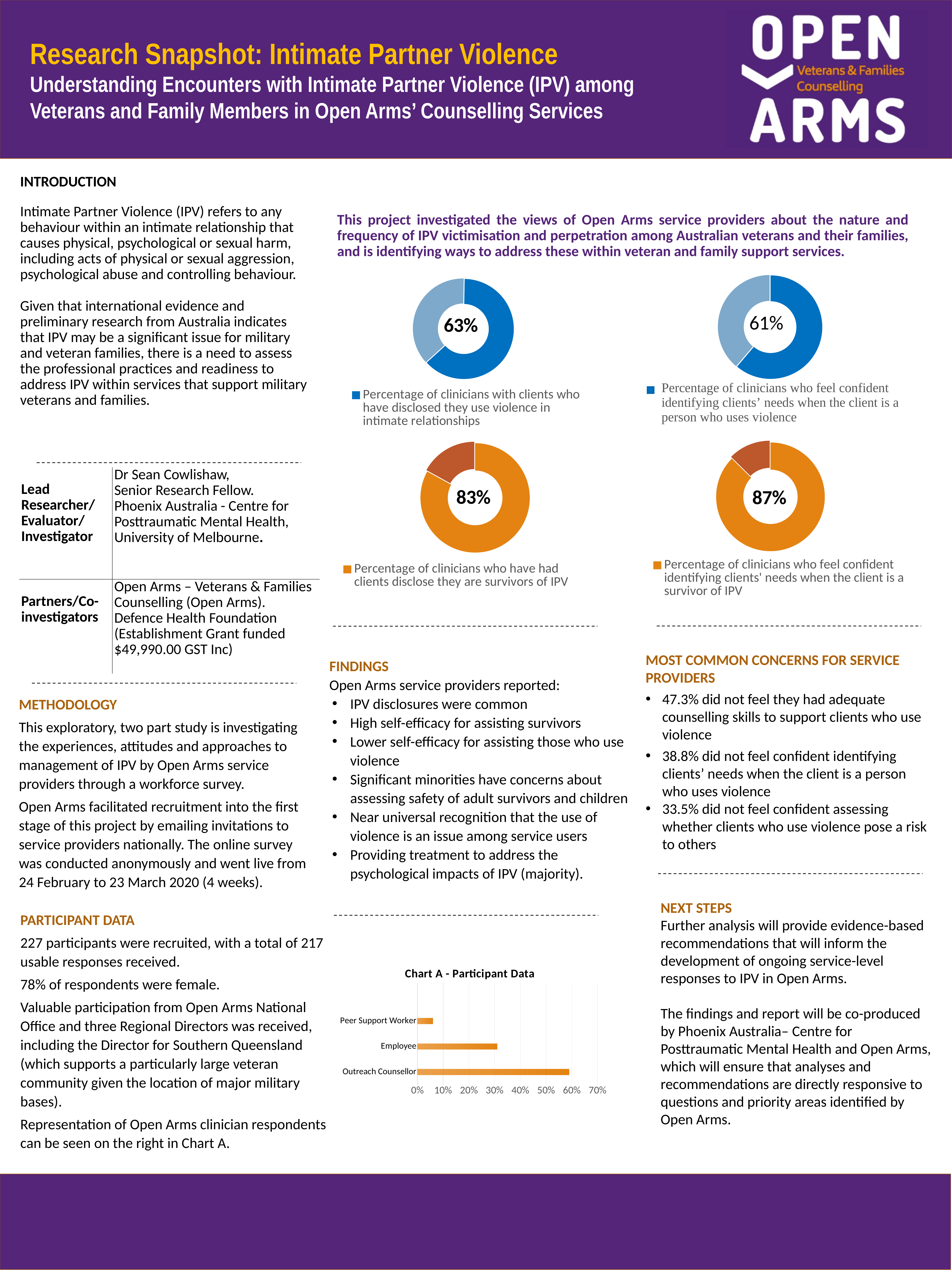
What type of chart is 'Chart A - Participant Data'? Bar chart In the donut chart labelled 'Percentage of clinicians who feel confident identifying clients' needs when the client is a survivor of IPV', what value is shown? 87% Which is larger: the percentage of clinicians who have had clients disclose they are survivors of IPV, or the percentage with clients who have disclosed they use violence? Percentage of clinicians who have had clients disclose they are survivors of IPV Of the four donut charts on the slide, which one shows the highest percentage? Percentage of clinicians who feel confident identifying clients' needs when the client is a survivor of IPV How many categories are shown in 'Chart A - Participant Data'? 3 In the donut chart labelled 'Percentage of clinicians who have had clients disclose they are survivors of IPV', what value is shown? 83% In the donut chart labelled 'Percentage of clinicians with clients who have disclosed they use violence in intimate relationships', what value is shown in the centre? 63% In 'Chart A - Participant Data', which category has the lowest value? Peer Support Worker In 'Chart A - Participant Data', which category has the highest value? Outreach Counsellor What is the difference between the percentage of clinicians who feel confident identifying needs of a survivor of IPV (87%) and those confident identifying needs of a person who uses violence (61%)? 26% In the donut chart labelled 'Percentage of clinicians who feel confident identifying clients' needs when the client is a person who uses violence', what value is shown? 61% In 'Chart A - Participant Data', is the value for Outreach Counsellor greater or less than 50%? greater